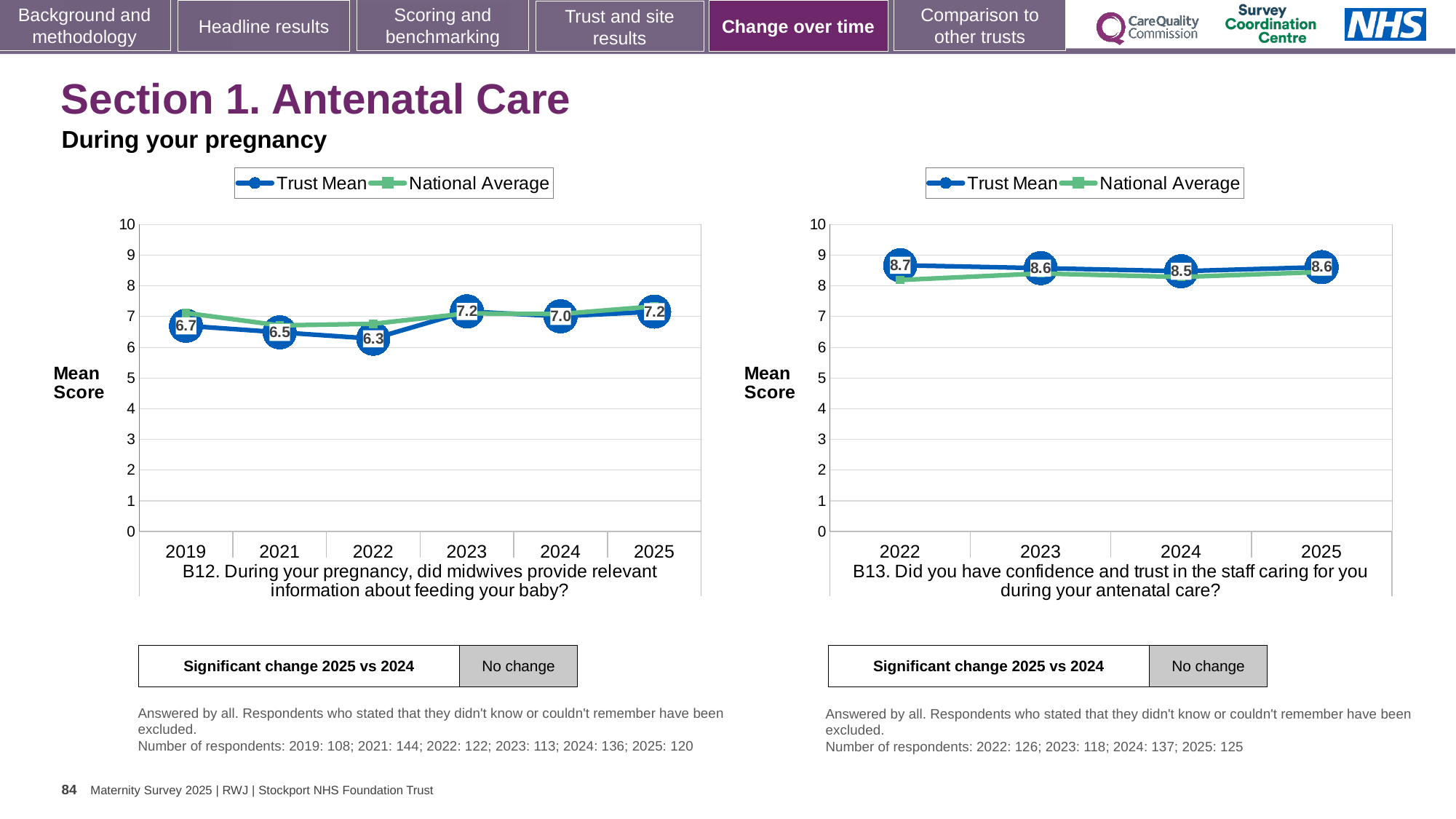
In the B13 chart on the right, what is the Trust Mean for 2025? 8.6 In the B13 chart on the right, which year has the highest Trust Mean? 2022 In the B13 chart on the right, which year has the lowest Trust Mean? 2024 In the B13 chart on the right, what is the difference between the Trust Mean for 2022 and the Trust Mean for 2024? 0.2 In the B12 chart on the left, which year has the lowest Trust Mean? 2022 In the B12 chart on the left, what is the Trust Mean for 2022? 6.3 How many years are plotted in the B13 chart on the right? 4 In the B12 chart on the left, is the Trust Mean higher in 2023 or in 2022? 2023 In the B12 chart on the left, what is the Trust Mean for 2024? 7.0 In the B12 chart on the left, is the National Average for 2022 greater or less than 7? less In the B12 chart on the left, what is the difference between the Trust Mean for 2025 and the Trust Mean for 2022? 0.9 What kind of chart is the B12 chart on the left? line chart